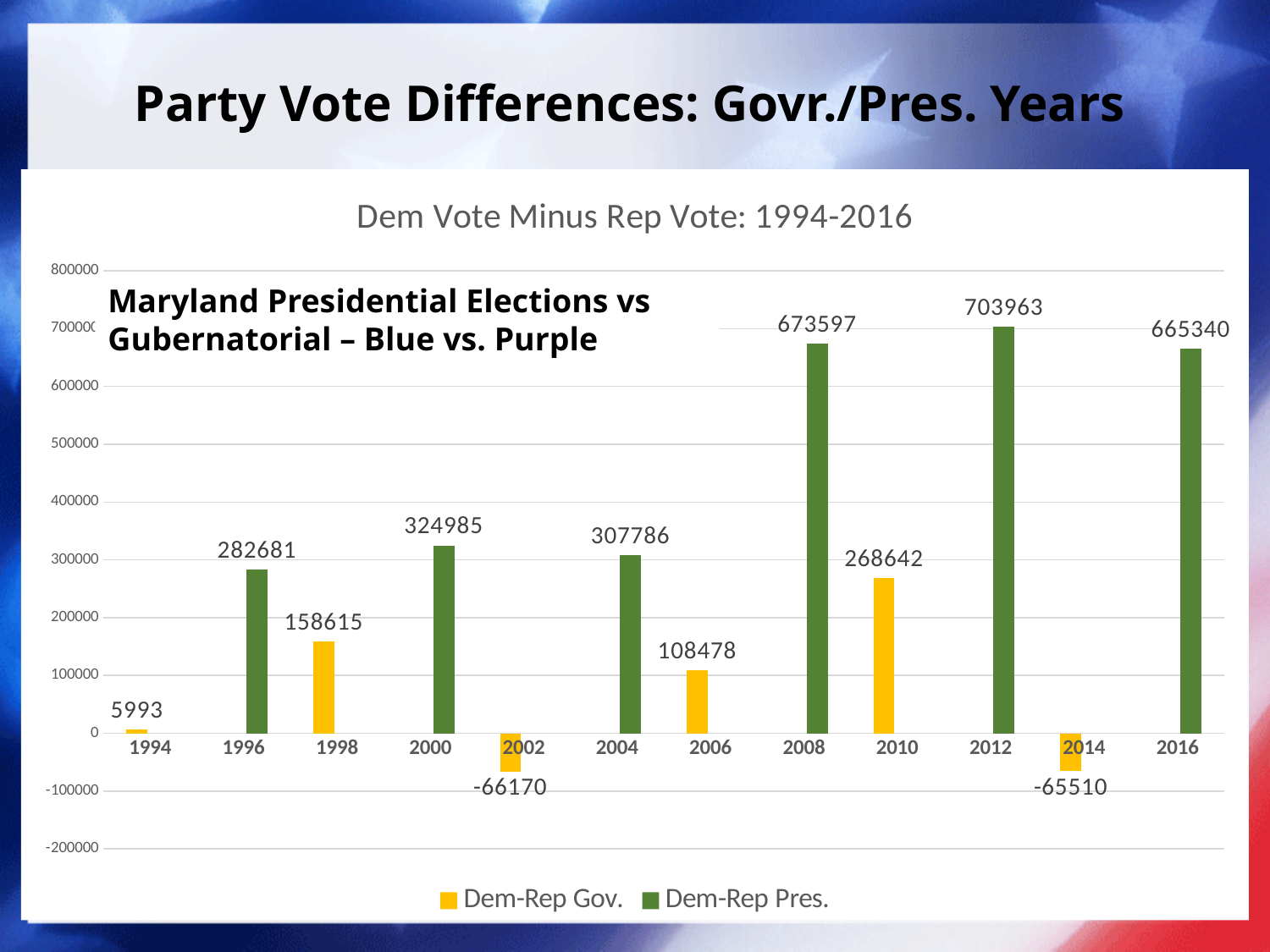
What is the difference between the Dem-Rep Gov. values for 2010 and 2006? 160164 How many series does the legend list? 2 Which year has the larger value, 2000 or 2004? 2000 What is the value for 2012 in the chart? 703963 What is the value shown for 1994? 5993 What is the Dem-Rep Gov. value for 2002? -66170 What is the Dem-Rep Gov. value for 2010? 268642 What is the difference between the values for 2012 and 2008? 30366 Which year has the highest value in the chart? 2012 What type of chart is shown on the slide? Bar chart How many years are shown on the x axis of the chart? 12 Which year has the lowest value in the chart? 2002